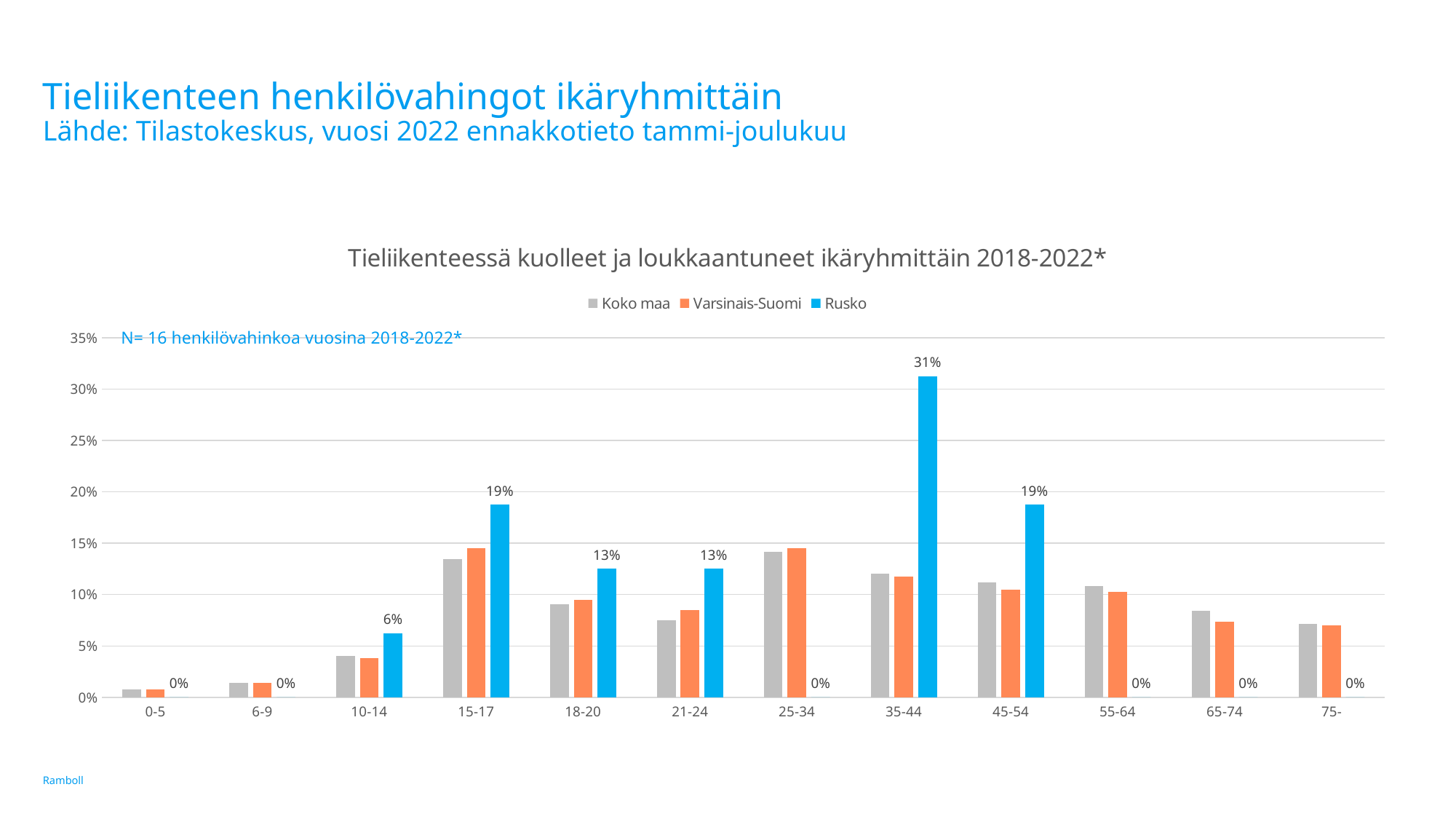
Is the value for Koko maa in the 15-17 age group greater or less than 10%? greater What is the value for Rusko in the 35-44 age group? 31% What colour are the bars for the Rusko series? blue How many series does the legend list? 3 How many age groups are shown on the x axis? 12 Is the value for Koko maa in the 75- age group greater or less than 10%? less What is the value for Rusko in the 10-14 age group? 6% In the 65-74 age group, which is larger: Koko maa or Varsinais-Suomi? Koko maa Which age group has the highest value for Rusko? 35-44 What kind of chart is shown on the slide? bar chart What is the value for Rusko in the 18-20 age group? 13% What is the difference between the Rusko values for the 35-44 and 45-54 age groups? 12%